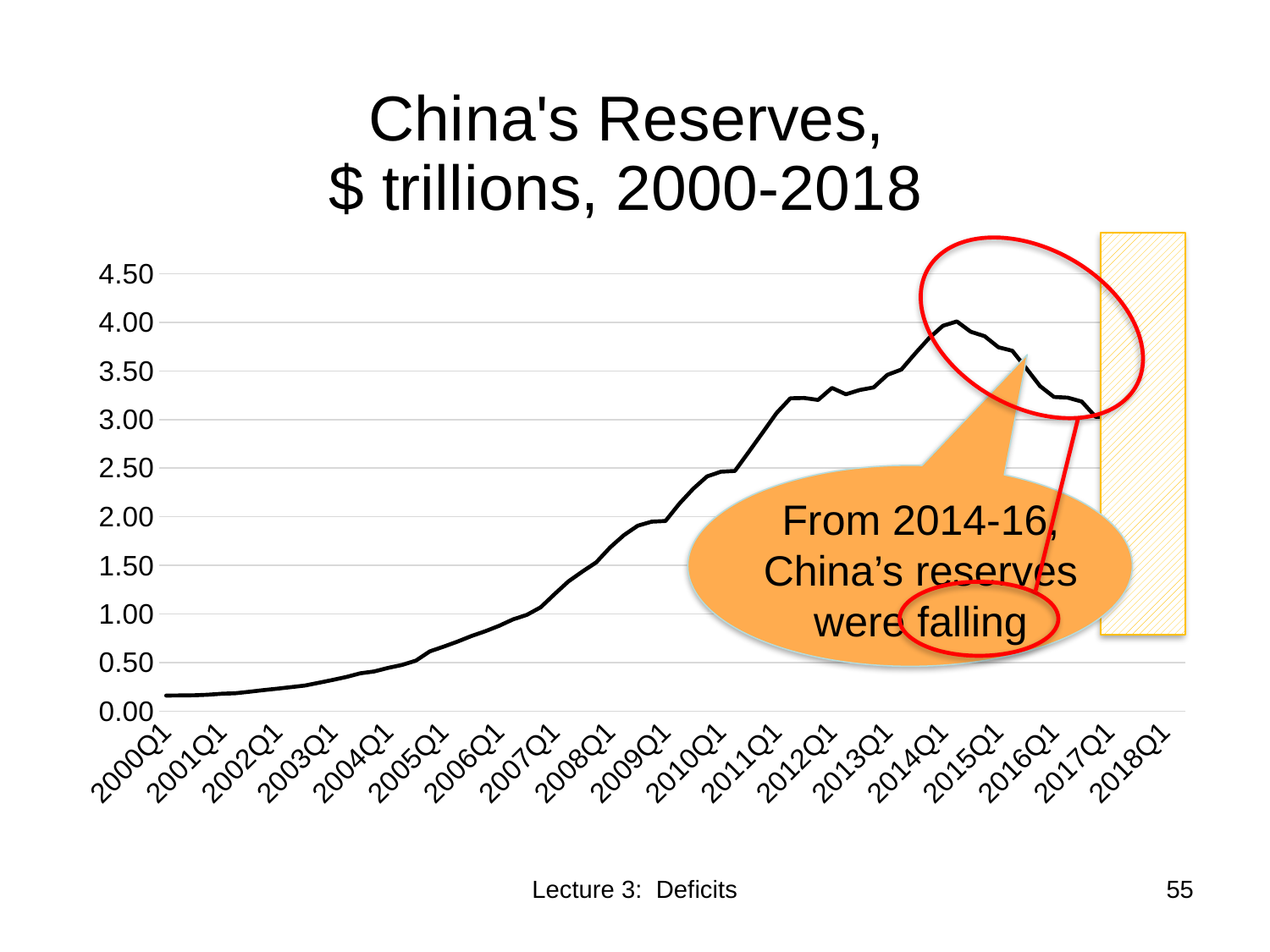
Do China's reserves rise or fall between 2000Q1 and 2014Q1? rise Is the value for 2014Q1 greater or less than 3.50? greater How many quarter labels are shown on the x axis? 19 What is the title of the chart? China's Reserves, $ trillions, 2000-2018 According to the callout on the chart, during which years were China's reserves falling? 2014-16 Is the value for 2010Q1 greater or less than 2.00? greater What kind of chart is shown on the slide? line chart Is the value for 2000Q1 greater or less than 0.50? less Which is larger, the value for 2014Q1 or the value for 2017Q1? 2014Q1 Do China's reserves rise or fall between 2014Q1 and 2017Q1? fall